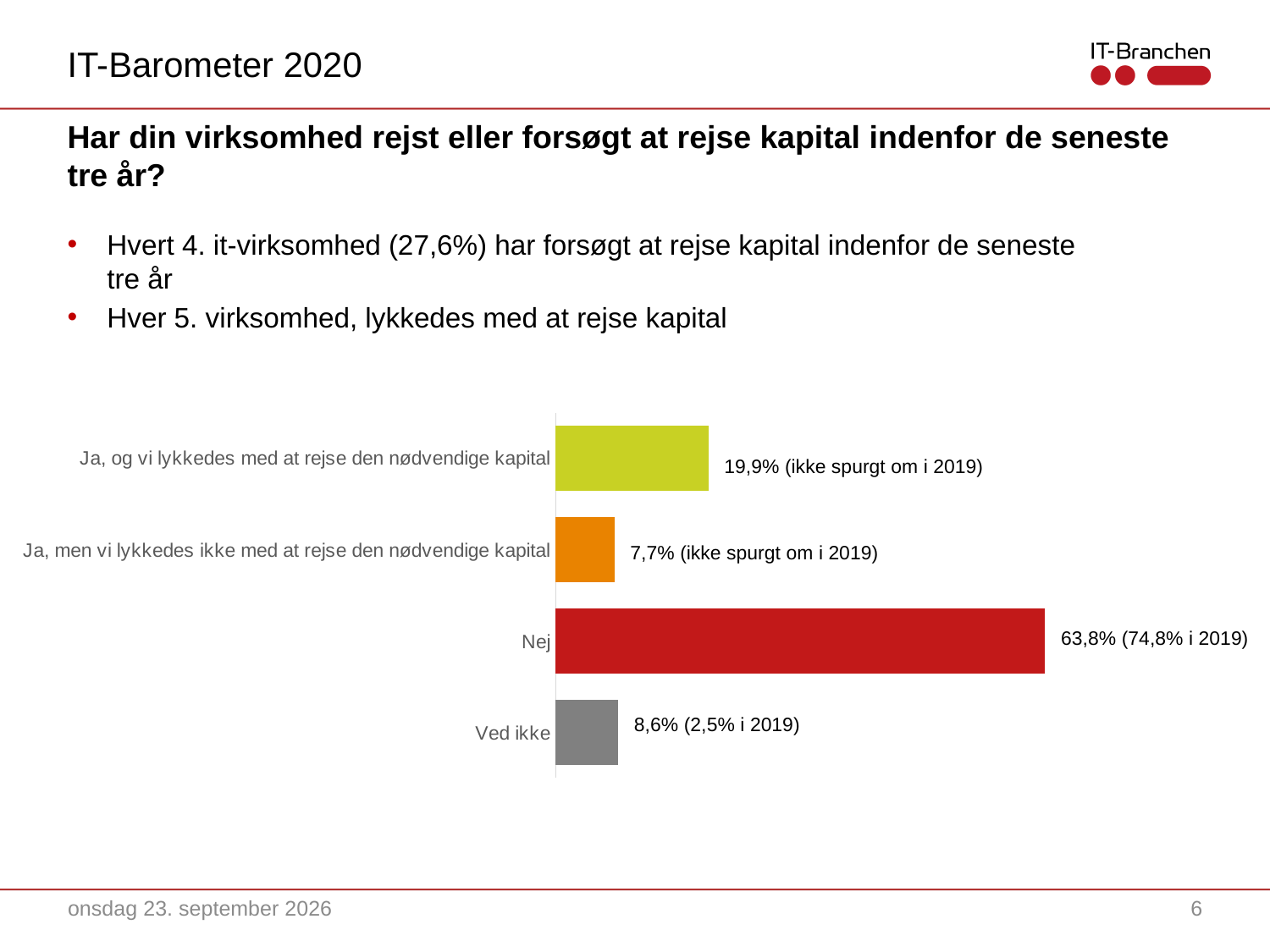
What is the value for "Ja, men vi lykkedes ikke med at rejse den nødvendige kapital"? 7,7% Which is larger: the value for "Ved ikke" or the value for "Ja, men vi lykkedes ikke med at rejse den nødvendige kapital"? Ved ikke What is the difference between the values for "Nej" and "Ja, og vi lykkedes med at rejse den nødvendige kapital"? 43,9% What was the 2019 value for "Ved ikke" as shown in the data label? 2,5% What is the value for "Nej"? 63,8% Which category has the lowest value? Ja, men vi lykkedes ikke med at rejse den nødvendige kapital What kind of chart is shown on the slide? Bar chart What is the value for "Ved ikke"? 8,6% What is the value for "Ja, og vi lykkedes med at rejse den nødvendige kapital"? 19,9% How many categories are shown in the chart? 4 Which category has the highest value? Nej What was the 2019 value for "Nej" as shown in the data label? 74,8%